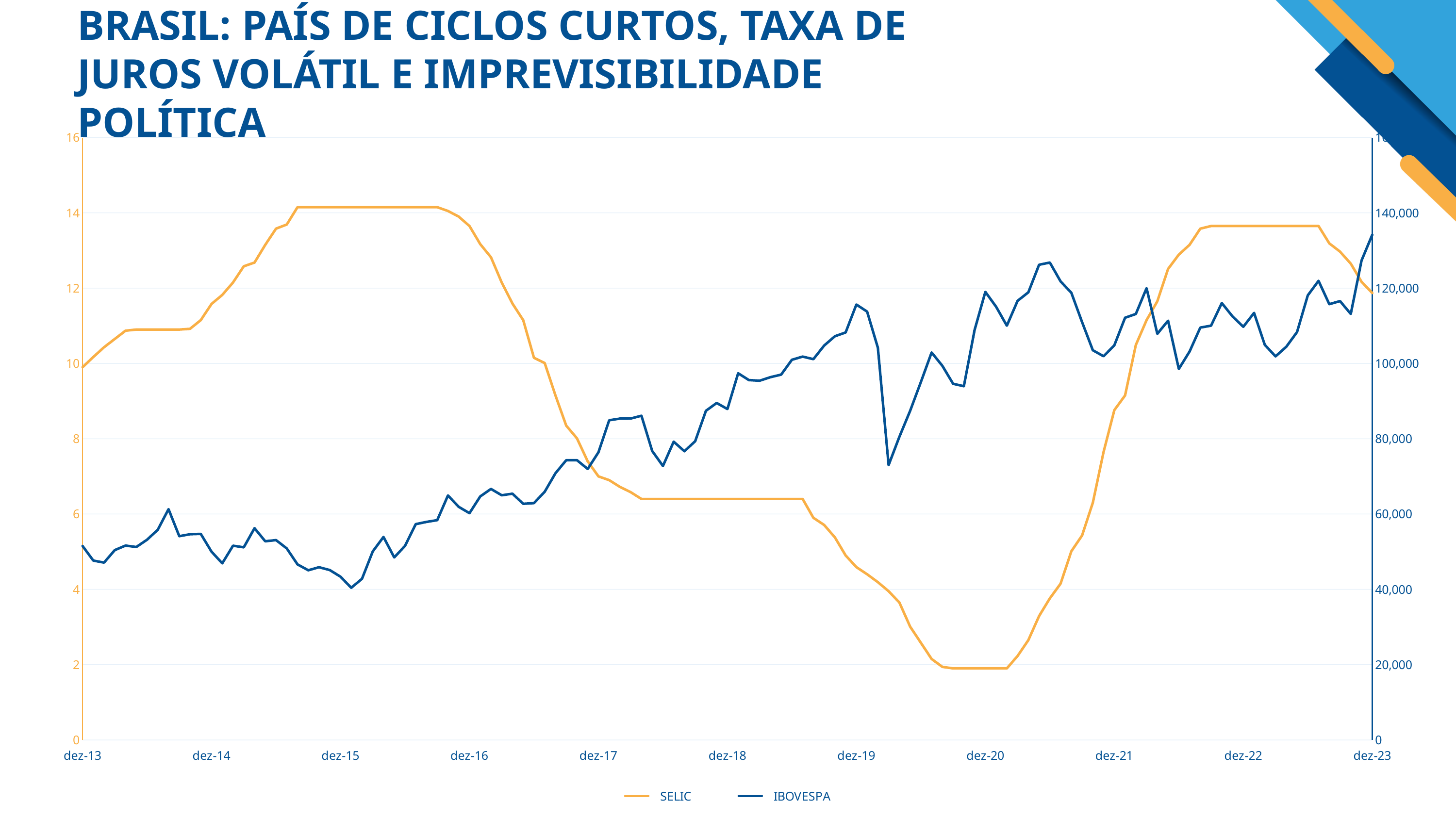
Is the IBOVESPA value at dez-15 greater or less than 60,000? less Is the SELIC value at dez-20 greater or less than 4? less What kind of chart is shown on the slide? line chart Is the IBOVESPA value at dez-23 greater or less than 120,000? greater Does the SELIC line rise or fall between dez-16 and dez-18? fall Which is larger, the SELIC value at dez-15 or at dez-20? dez-15 How many series does the legend list? 2 Which colour is used for the SELIC line? orange How many date labels are shown on the x axis? 11